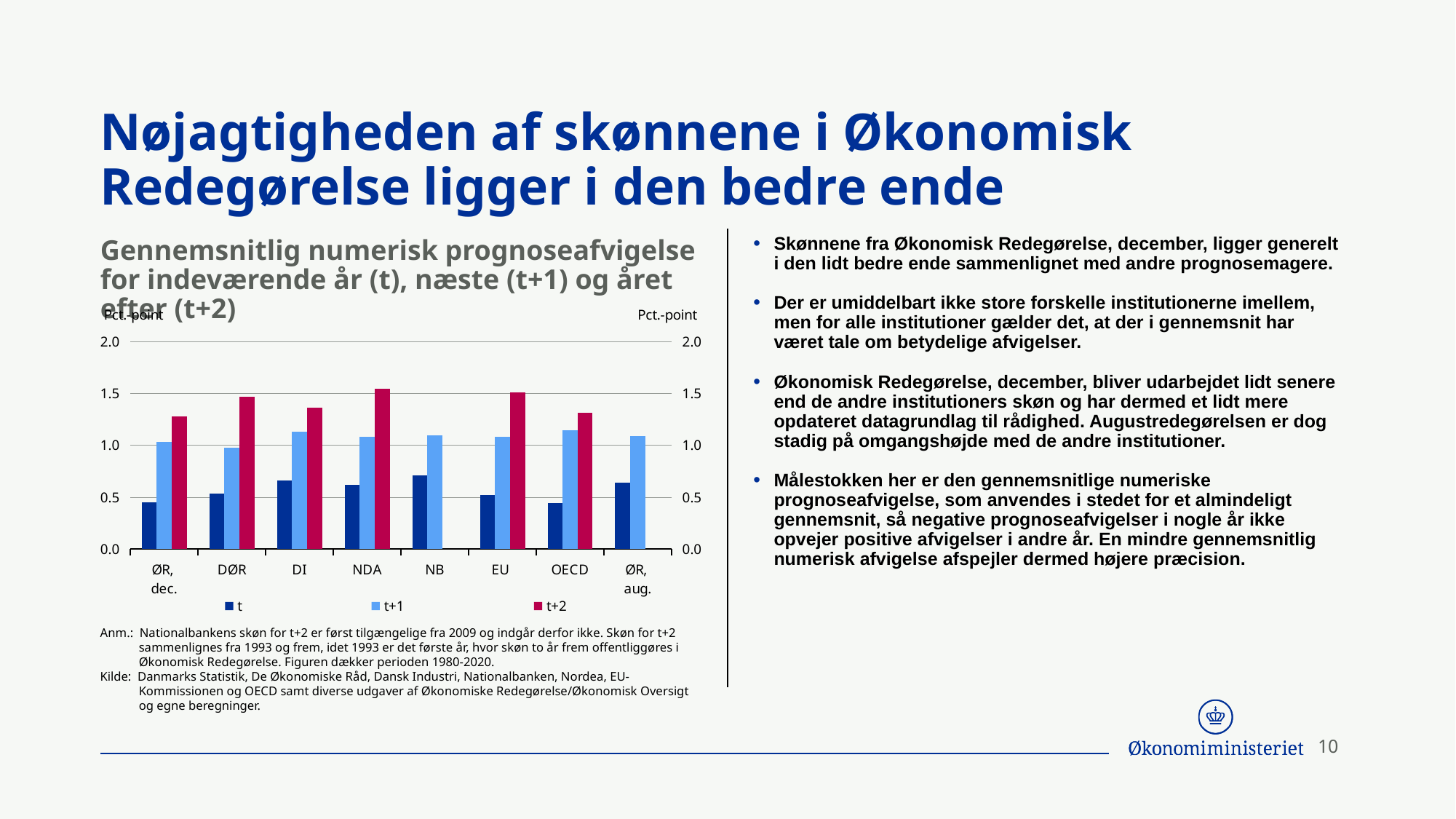
Which categories have no t+2 bar in the chart? NB and ØR, aug. Which is larger: the t+2 value for DØR or the t+2 value for ØR, dec.? DØR Is the value of the t+2 series for ØR, dec. greater or less than 1.5? less What kind of chart is shown on the slide? bar chart Which series are listed in the chart legend? t, t+1, t+2 How many series does the chart legend list? 3 How many categories are shown on the x axis of the chart? 8 Is the value of the t series for ØR, dec. greater or less than 0.5? less What unit is shown on the chart's vertical axis? Pct.-point Is the value of the t+2 series for NDA greater or less than 1.5? greater Which category has the highest value in the t series? NB